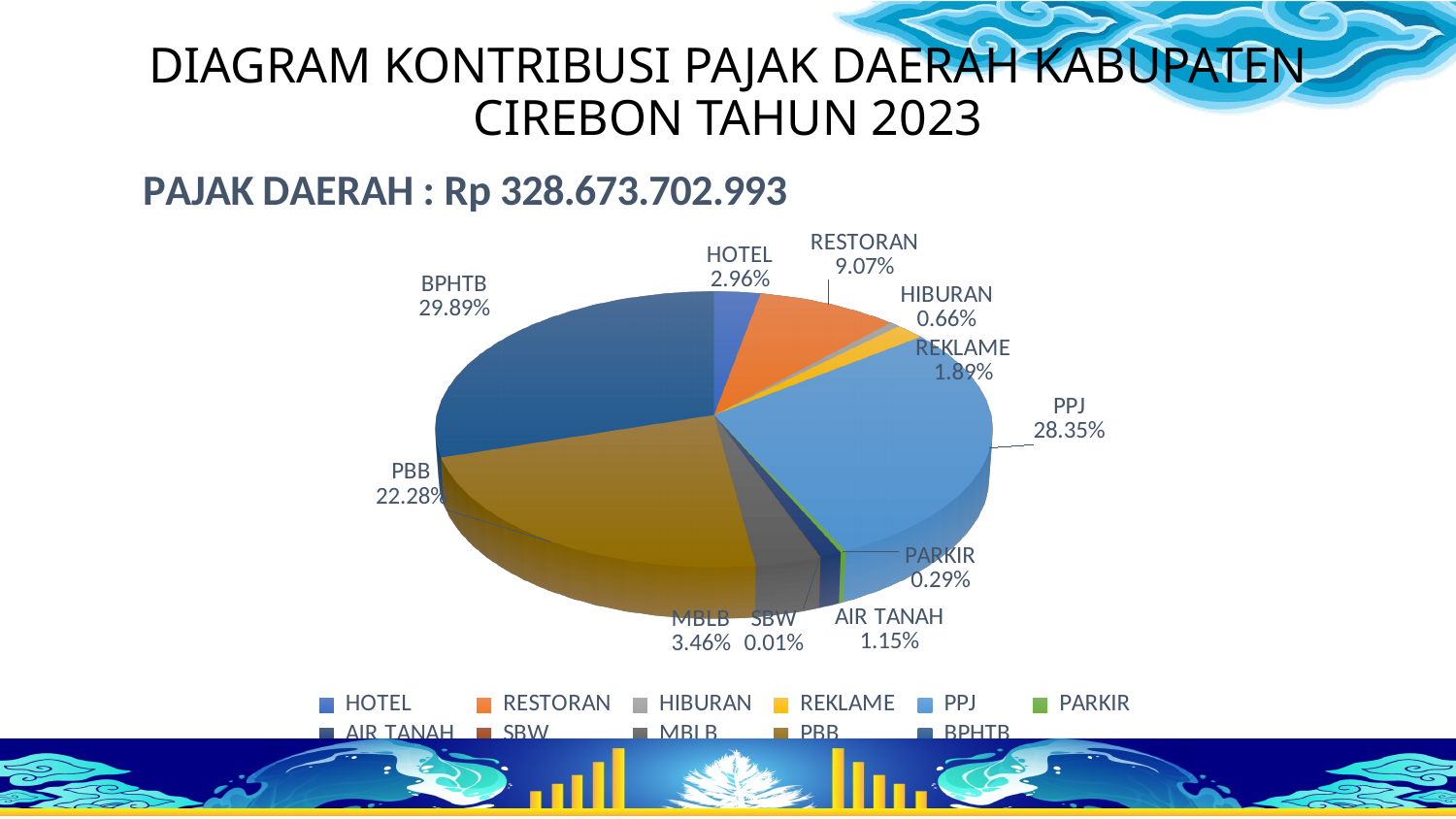
What is the value shown for SBW? 0.01% Which category has the smallest share of the pie? SBW Which is larger, the share for MBLB or the share for HOTEL? MBLB How many categories does the legend list? 11 What is the difference between the shares of BPHTB and PPJ? 1.54% What share of the pie does BPHTB have? 29.89% What is the value shown for RESTORAN? 9.07% What is the value shown for PBB? 22.28% What kind of chart is shown on the slide? Pie chart What share of the pie does PPJ have? 28.35% Which category has the largest share of the pie? BPHTB What total amount of PAJAK DAERAH is stated above the chart? Rp 328.673.702.993